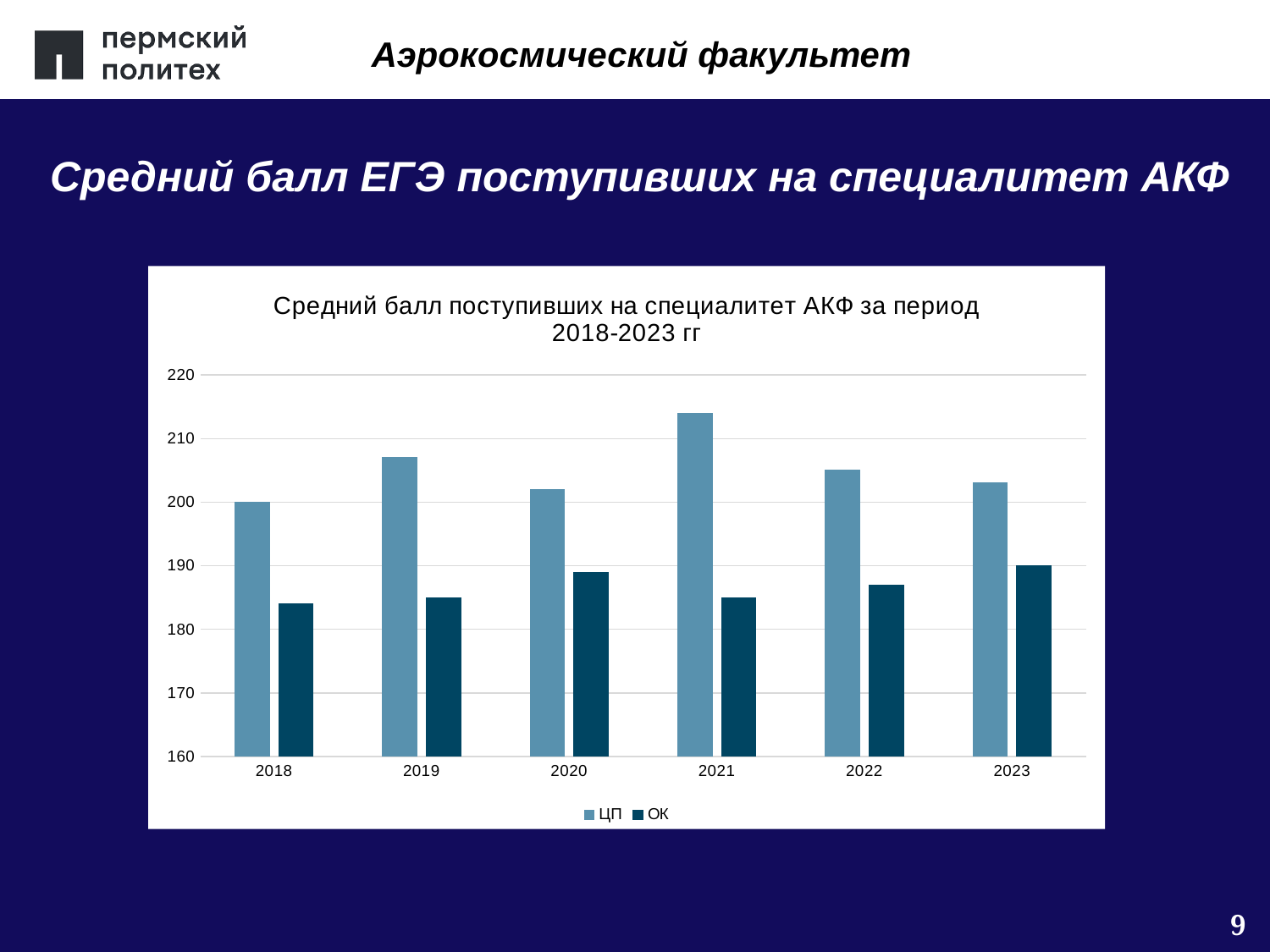
Which is larger, the ЦП value for 2021 or the ЦП value for 2019? 2021 Is the ЦП value for 2021 greater or less than 210? greater What is the title of the chart? Средний балл поступивших на специалитет АКФ за период 2018-2023 гг Is the ЦП value for 2019 greater or less than 200? greater In which year is the ЦП value the highest? 2021 What are the two series named in the chart legend? ЦП and ОК How many years are shown on the x axis of the chart? 6 What kind of chart is shown on the slide? bar chart Is the ОК value for 2021 greater or less than 180? greater In 2020, which series has the larger value, ЦП or ОК? ЦП How many series does the chart legend list? 2